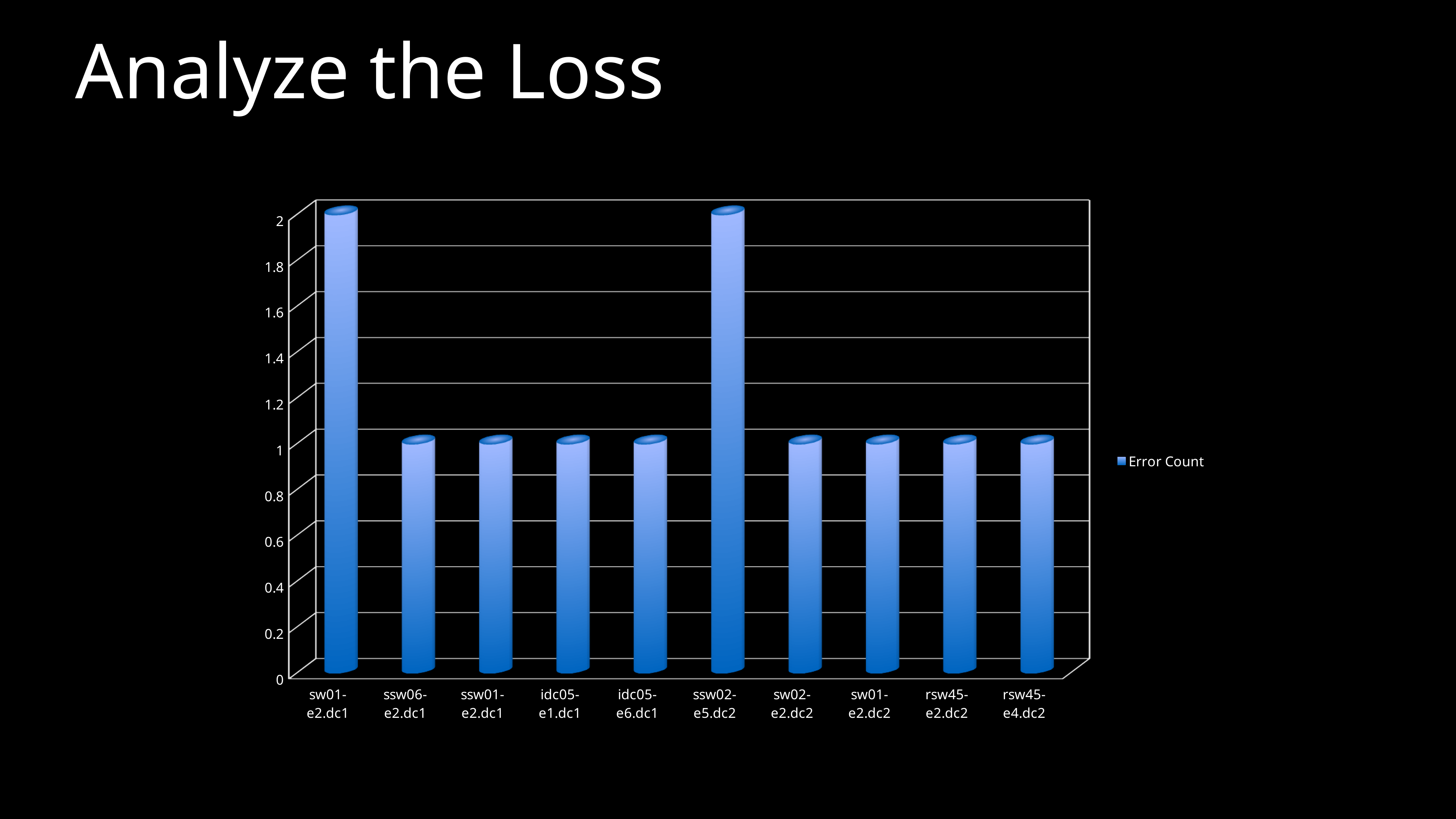
What is the Error Count for ssw06-e2.dc1? 1 How many categories are shown on the x axis? 10 What kind of chart is shown on the slide? Bar chart What is the Error Count for rsw45-e4.dc2? 1 Which has a larger Error Count, sw01-e2.dc1 or idc05-e1.dc1? sw01-e2.dc1 Is the Error Count for sw01-e2.dc1 greater or less than 1.8? greater Is the Error Count for idc05-e6.dc1 greater or less than 1.2? less Which has a larger Error Count, sw02-e2.dc2 or ssw02-e5.dc2? ssw02-e5.dc2 What is the difference in Error Count between ssw02-e5.dc2 and sw01-e2.dc2? 1 What is the Error Count for sw01-e2.dc1? 2 How many series does the legend list? 1 What is the Error Count for ssw02-e5.dc2? 2